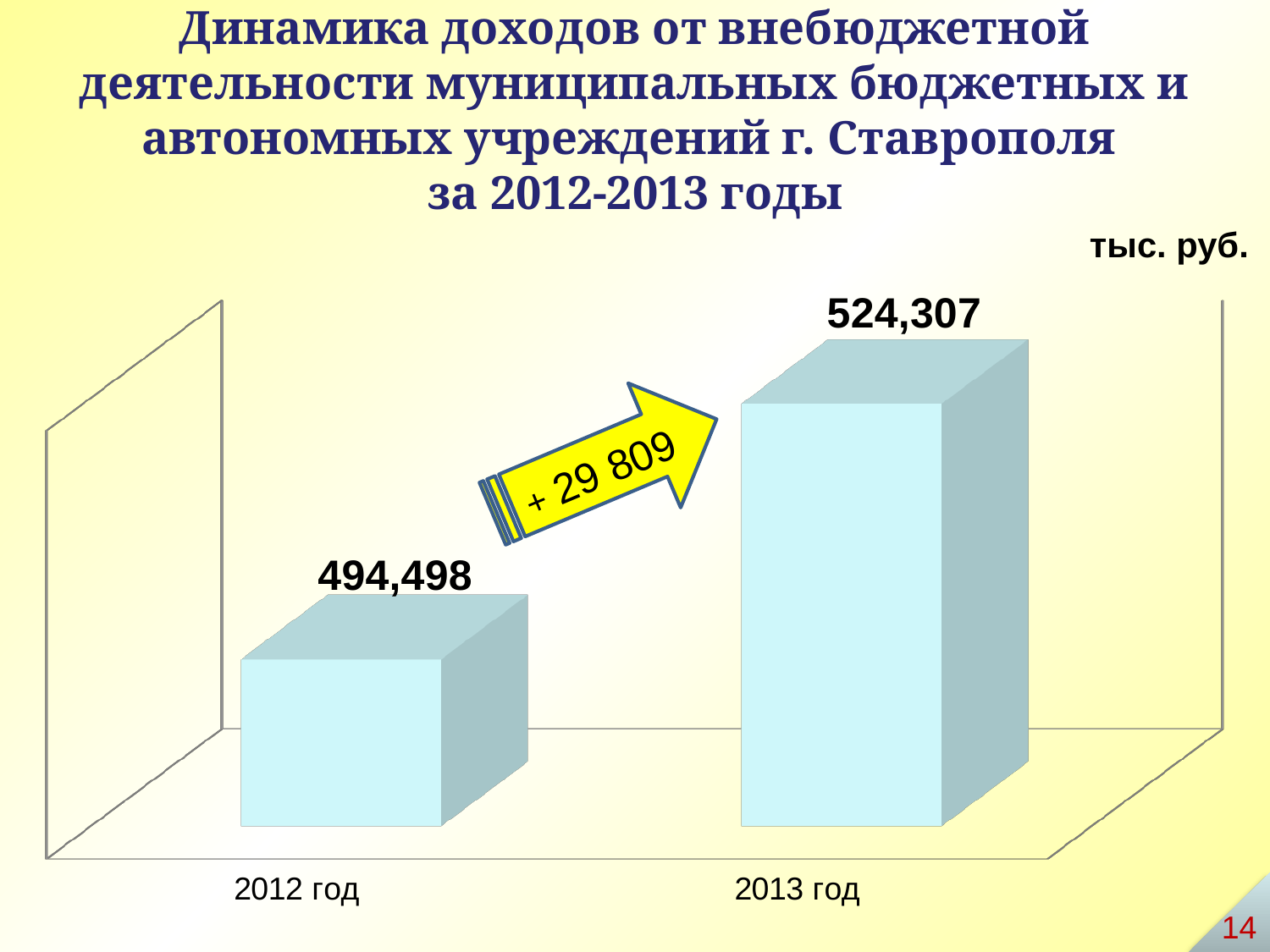
Which year has the highest value? 2013 год What increase is written on the arrow between the two bars? + 29 809 Which is larger, the value for 2012 год or the value for 2013 год? 2013 год What is the difference between the values for 2013 год and 2012 год? 29,809 What is the value for 2013 год? 524,307 What kind of chart is shown on the slide? Bar chart What unit of measurement is indicated on the chart? тыс. руб. Which year has the lowest value? 2012 год How many categories are shown on the chart? 2 Do the values rise or fall from 2012 год to 2013 год? Rise What is the value for 2012 год? 494,498